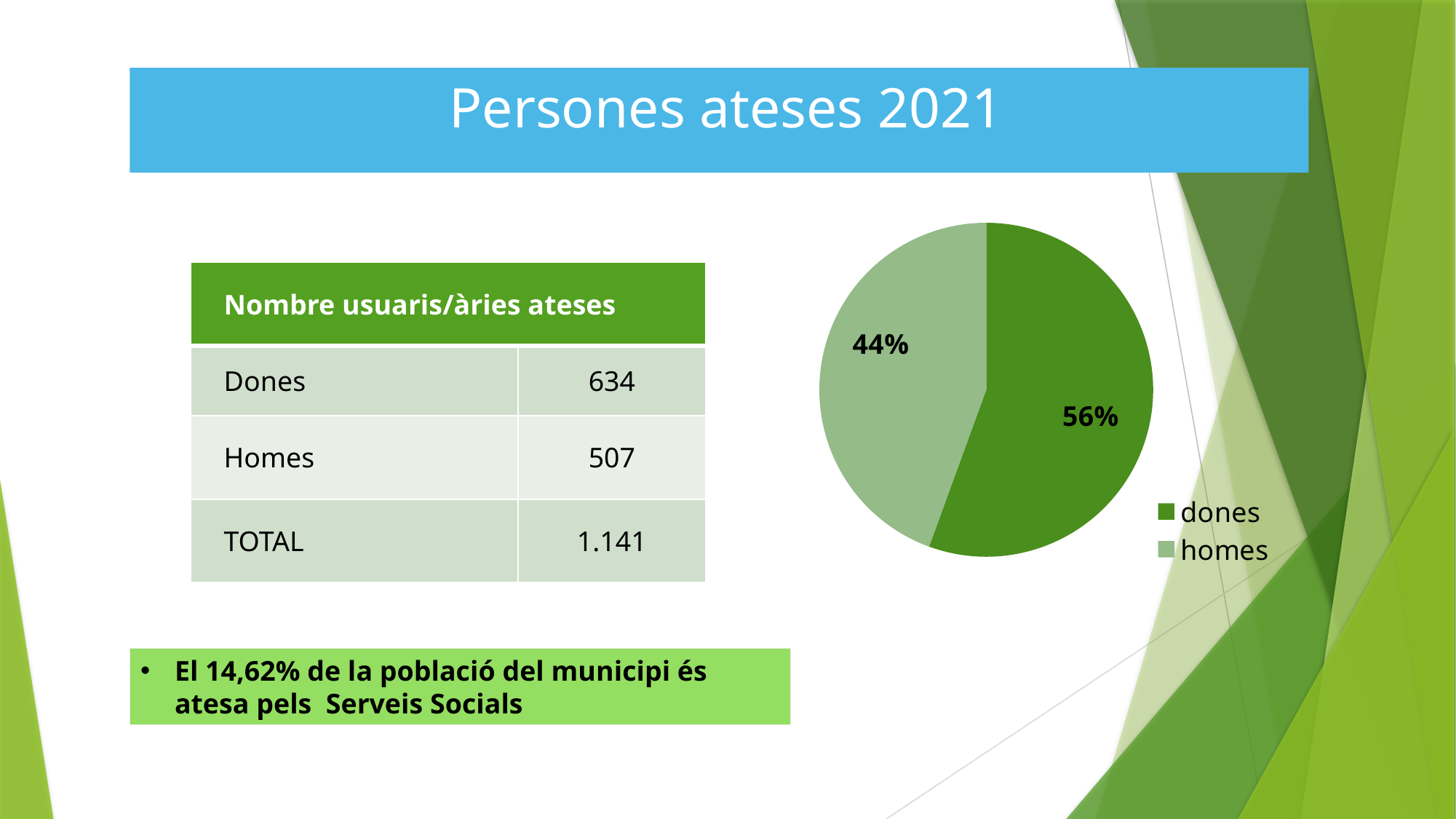
What share of the pie chart does the 'homes' slice represent? 44% Which slice of the pie chart is the smallest? homes Which legend entry of the pie chart is shown in the darker green colour? dones How many slices does the pie chart have? 2 Which slice of the pie chart is the largest? dones How many entries does the pie chart legend list? 2 What is the difference in percentage points between the 'dones' and 'homes' slices of the pie chart? 12% What share of the pie chart does the 'dones' slice represent? 56% Which legend entry of the pie chart is shown in the lighter green colour? homes Which is larger in the pie chart, the 'dones' slice or the 'homes' slice? dones What kind of chart is shown on the slide? pie chart